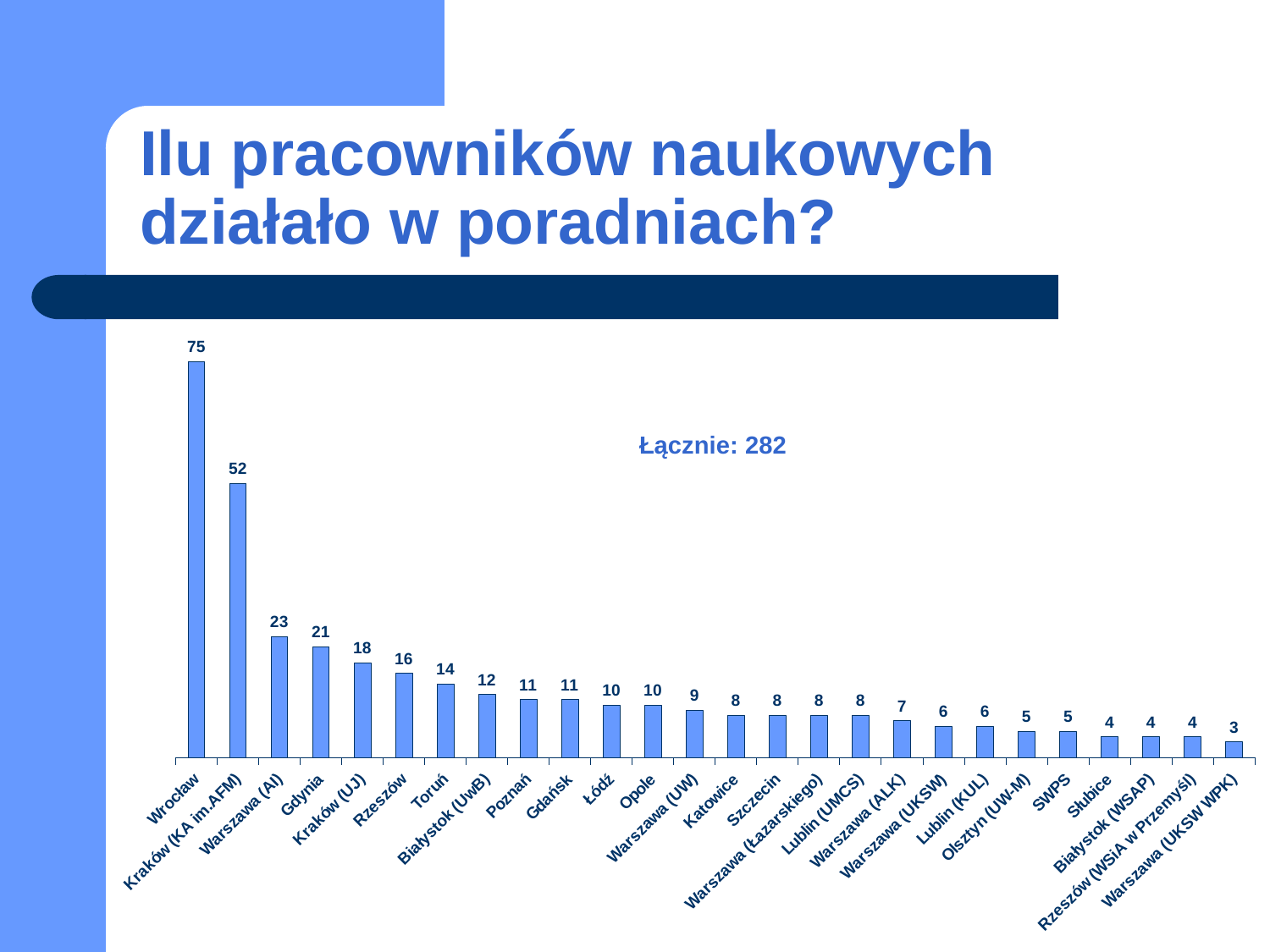
How many categories are shown on the x axis? 26 Do the values rise or fall from left to right along the x axis? fall Which is larger, the value for Warszawa (AI) or the value for Kraków (UJ)? Warszawa (AI) Which category has the highest value? Wrocław What is the difference between the values for Wrocław and Kraków (KA im.AFM)? 23 What is the value for Kraków (KA im.AFM)? 52 What is the value for Gdynia? 21 Which category has the lowest value? Warszawa (UKSW WPK) What is the value for Toruń? 14 What is the value for Wrocław? 75 What type of chart is shown on the slide? bar chart What total is stated in the text label inside the chart area? Łącznie: 282